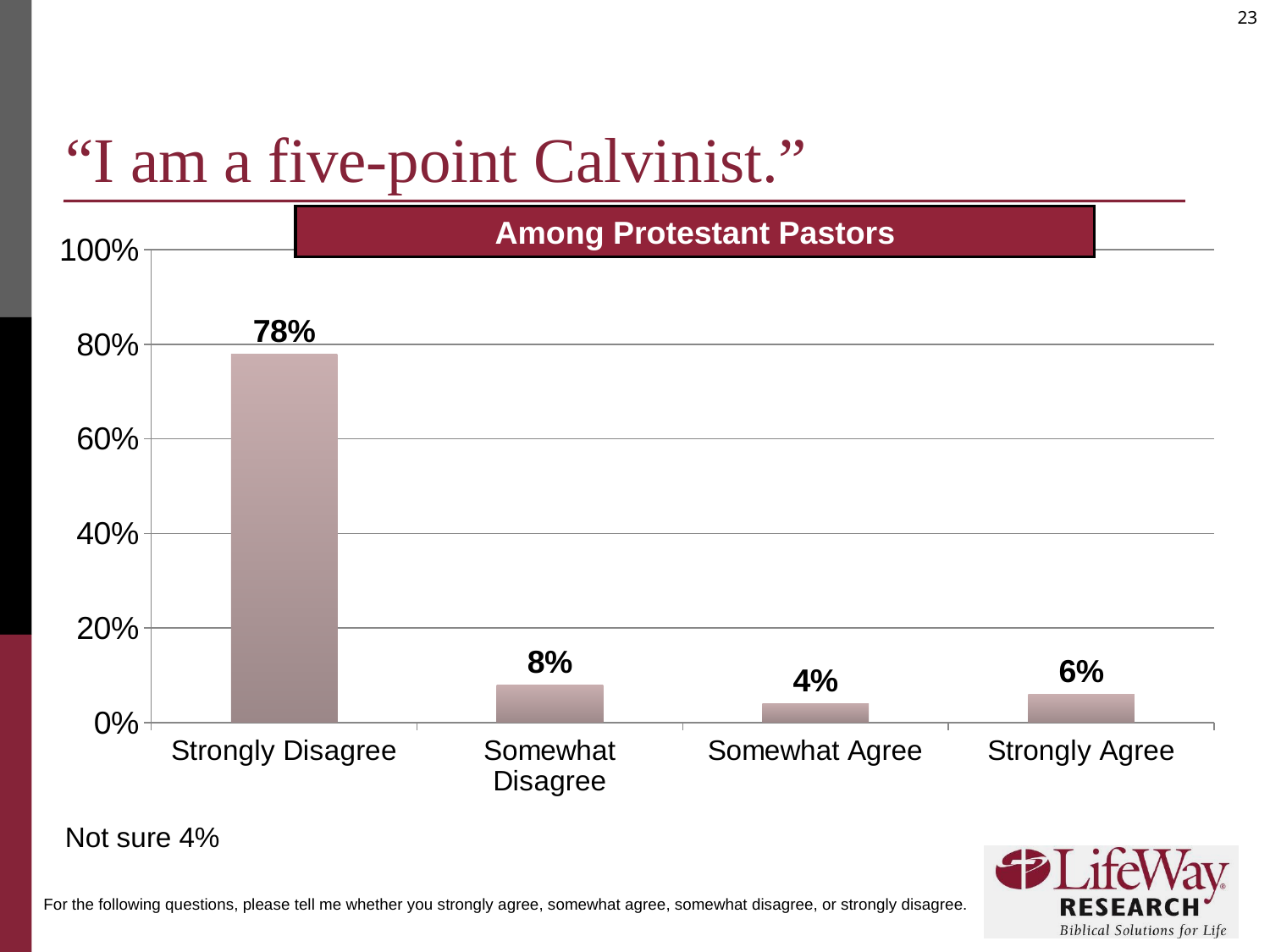
What kind of chart is shown on the slide? Bar chart What is the value for Strongly Agree? 6% What percentage of Protestant pastors strongly disagree with the statement "I am a five-point Calvinist"? 78% What percentage of pastors answered "Not sure", according to the note below the chart? 4% Which response category has the highest value? Strongly Disagree Is the value for Strongly Disagree greater or less than 60%? greater How many response categories are shown on the x axis of the chart? 4 What is the difference between the Strongly Disagree and Somewhat Disagree values? 70 percentage points Which response category has the lowest value? Somewhat Agree What is the value for Somewhat Agree? 4% What is the value for Somewhat Disagree? 8% Which is larger, the value for Strongly Agree or the value for Somewhat Agree? Strongly Agree